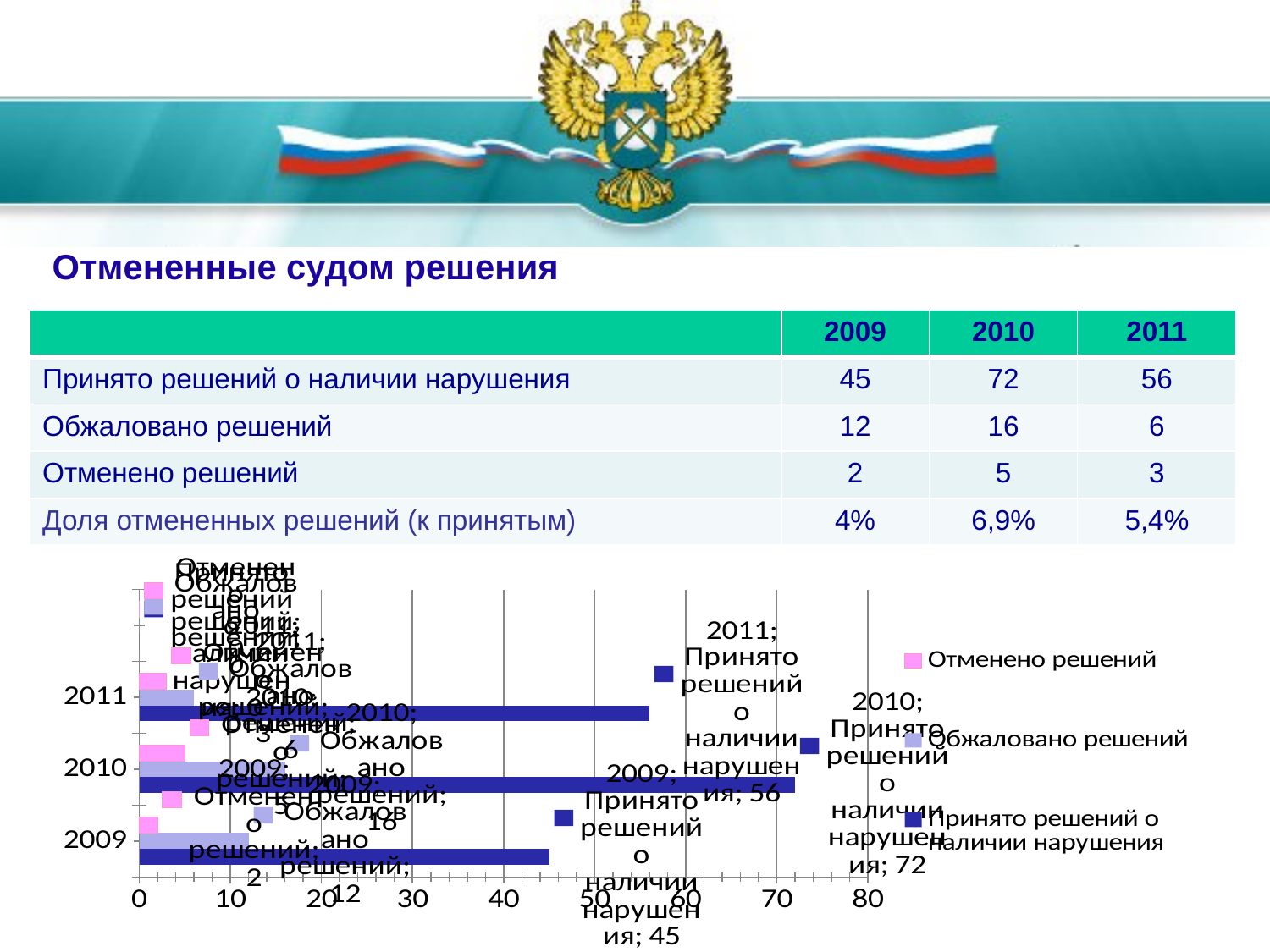
Is the 'Принято решений о наличии нарушения' bar for 2011 greater or less than 50? greater What is the value of 'Отменено решений' for 2011 in the chart? 3 What is the value of 'Принято решений о наличии нарушения' for 2010 in the chart? 72 What kind of chart is shown on the slide? bar chart What is the value of 'Принято решений о наличии нарушения' for 2009 in the chart? 45 What is the value of 'Обжаловано решений' for 2010 in the chart? 16 How many year categories are plotted on the chart's vertical axis? 3 Which series is shown in pink in the chart legend? Отменено решений How many series does the chart legend list? 3 What is the difference between the 'Принято решений о наличии нарушения' values for 2010 and 2011 in the chart? 16 Which year has the lowest value for 'Отменено решений' in the chart? 2009 Which year has the highest value for 'Принято решений о наличии нарушения' in the chart? 2010